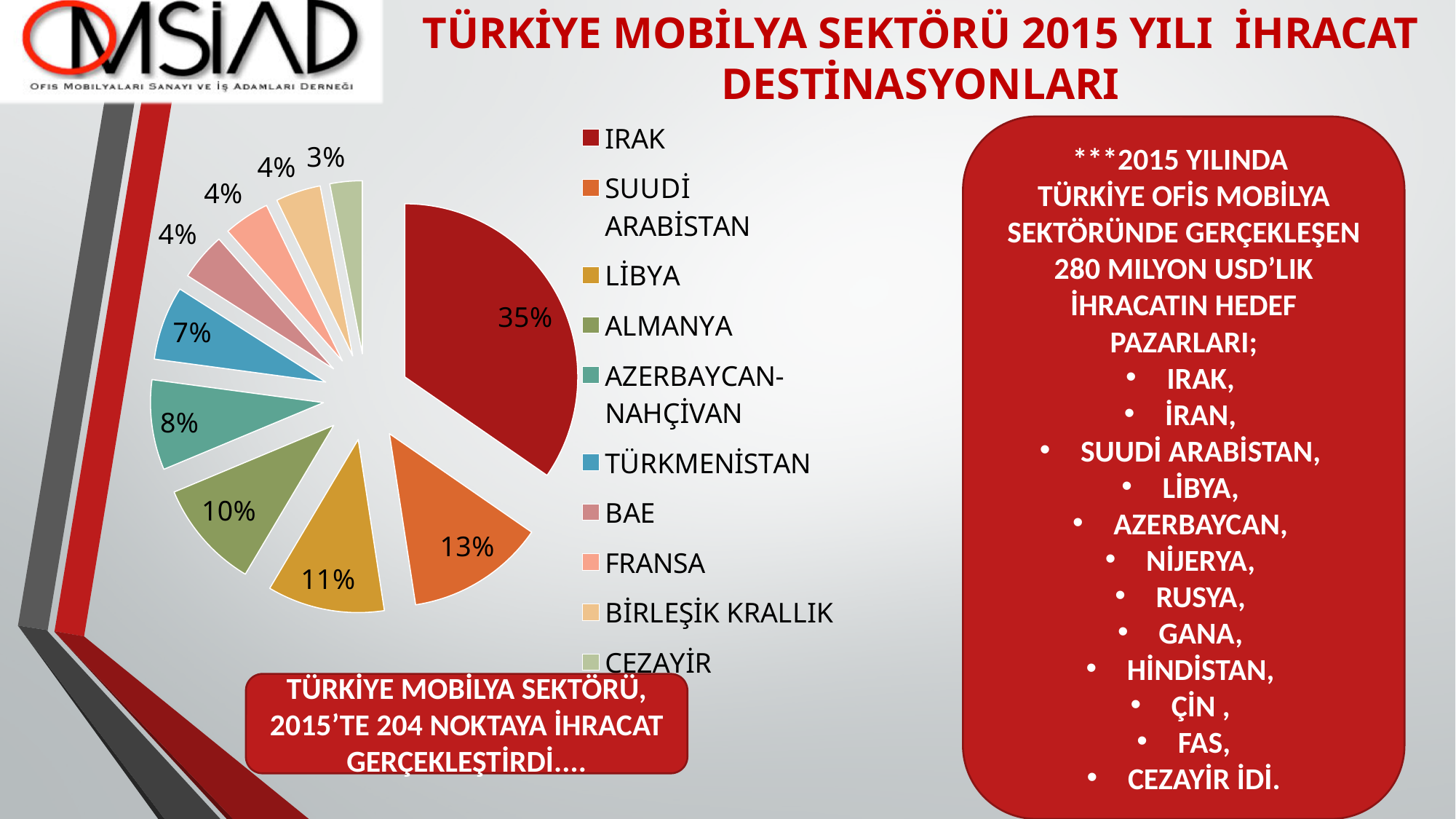
Which country has the largest slice of the pie chart? IRAK What is the difference in percentage points between IRAK and SUUDİ ARABİSTAN? 22 Which is larger, the share for AZERBAYCAN-NAHÇİVAN or the share for TÜRKMENİSTAN? AZERBAYCAN-NAHÇİVAN What percentage is shown for TÜRKMENİSTAN? 7% What share of the pie does IRAK account for? 35% What type of chart is shown on the slide? Pie chart How many countries are listed in the pie chart legend? 10 What percentage is shown for LİBYA? 11% Which country has the smallest slice of the pie chart? CEZAYİR What colour is the slice representing IRAK? Dark red What share does ALMANYA have in the pie chart? 10% What percentage is shown for SUUDİ ARABİSTAN? 13%